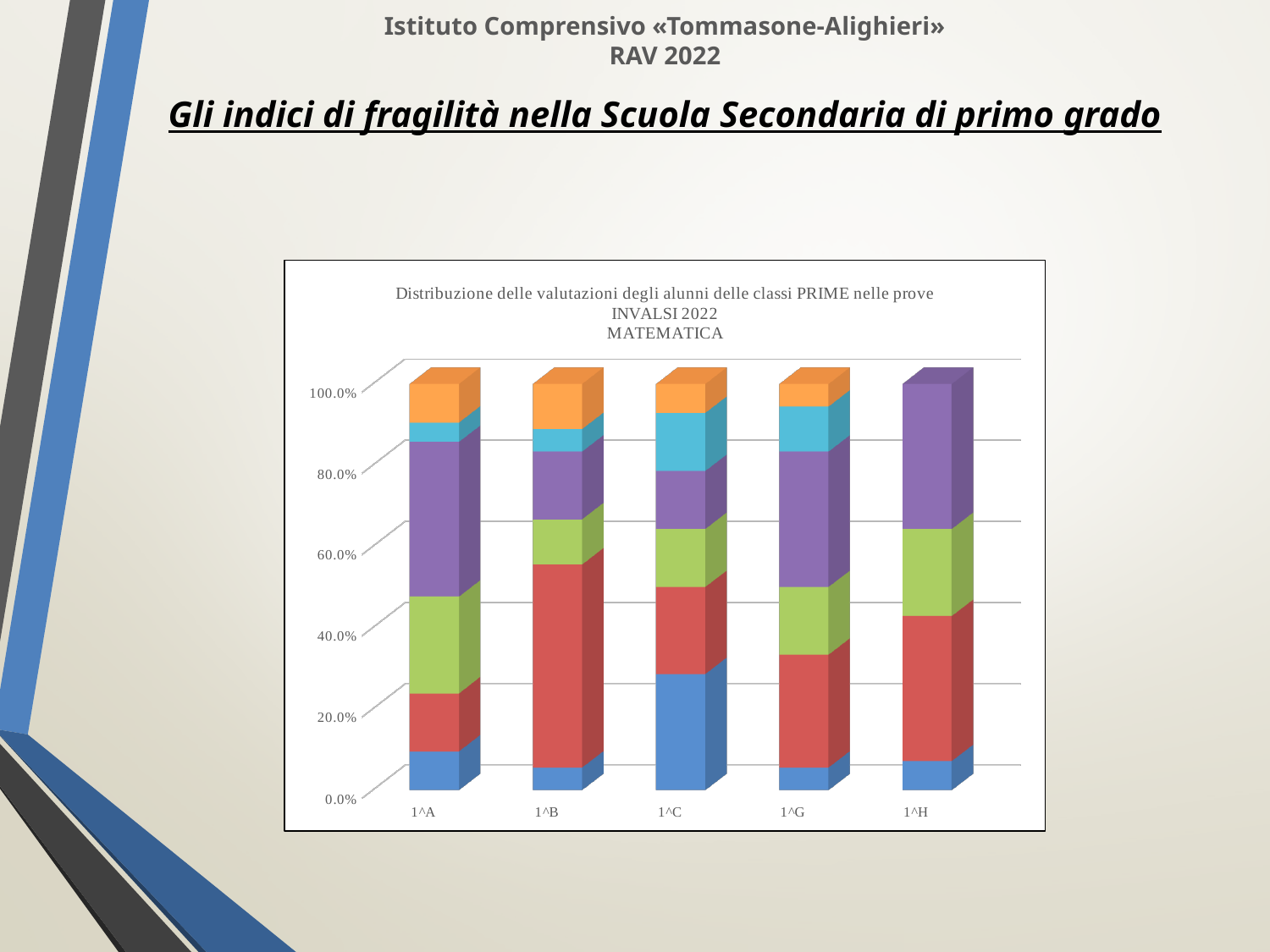
Is the blue segment for 1^B greater or less than 20%? less Which class has no orange or light-blue segment at the top of its bar? 1^H Which class has the largest red segment? 1^B Is the blue segment for 1^A larger or smaller than the blue segment for 1^C? smaller Which class is the last category on the x axis? 1^H What kind of chart is shown on the slide? Stacked bar chart How many classes are shown on the x axis of the chart? 5 Is the red segment for 1^B greater or less than 40%? greater How many coloured segments make up the bar for 1^H? 4 What subject is named in the chart title? MATEMATICA Is the blue segment for 1^C greater or less than 20%? greater Which class has the largest blue (bottom) segment? 1^C